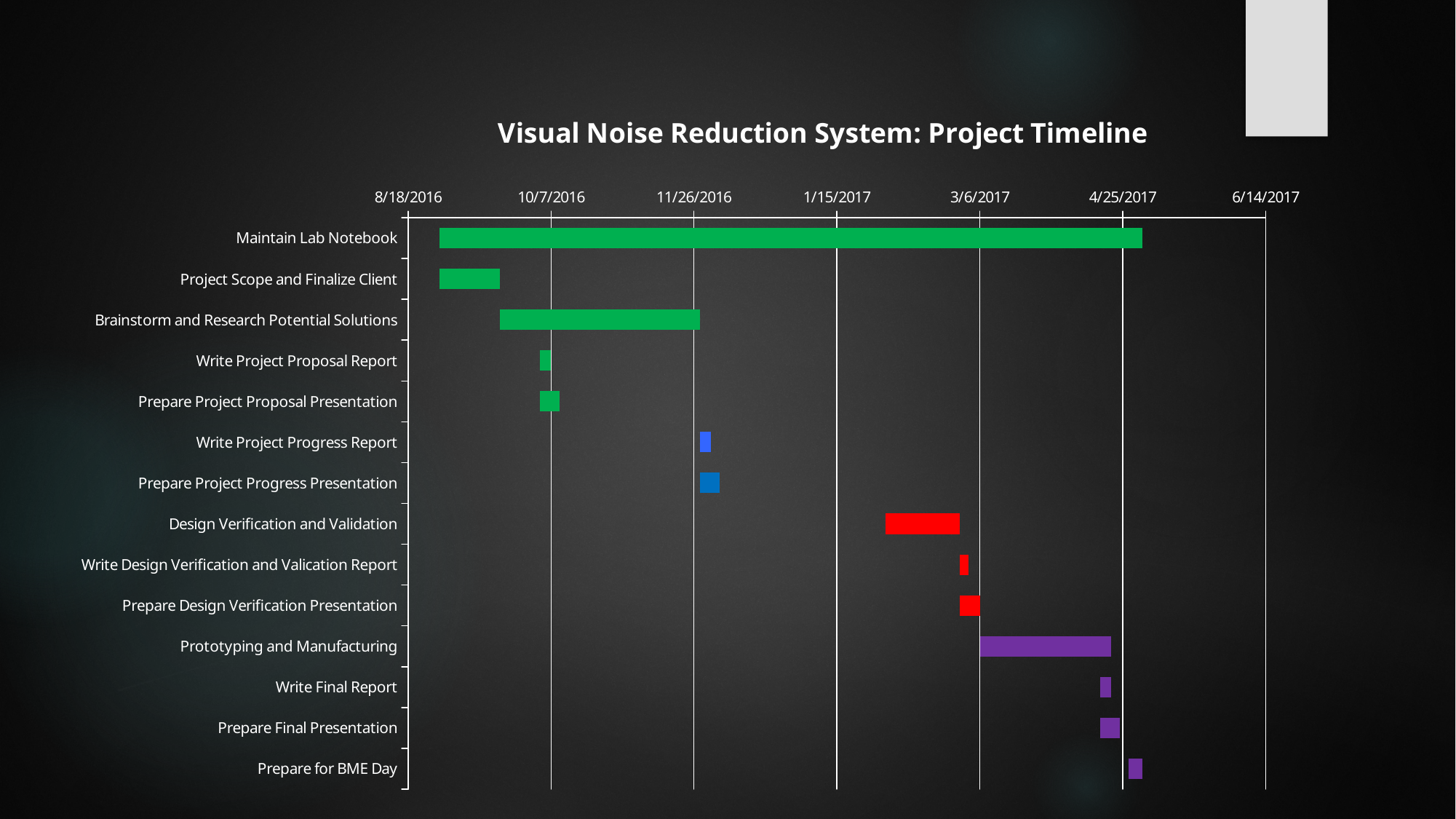
Does the bar for Project Scope and Finalize Client end before or after 10/7/2016? before Does the bar for Design Verification and Validation end before or after 3/6/2017? before What kind of chart is shown on the slide? bar chart Which task has the longer bar, Brainstorm and Research Potential Solutions or Project Scope and Finalize Client? Brainstorm and Research Potential Solutions What is the first date label shown on the horizontal axis? 8/18/2016 Which task has the longest bar in the chart? Maintain Lab Notebook Does the bar for Maintain Lab Notebook end before or after 4/25/2017? after What is the title of the chart? Visual Noise Reduction System: Project Timeline How many tasks are listed on the vertical axis of the chart? 14 What colour is the bar for Prototyping and Manufacturing? purple Which task has the longer bar, Prototyping and Manufacturing or Design Verification and Validation? Prototyping and Manufacturing